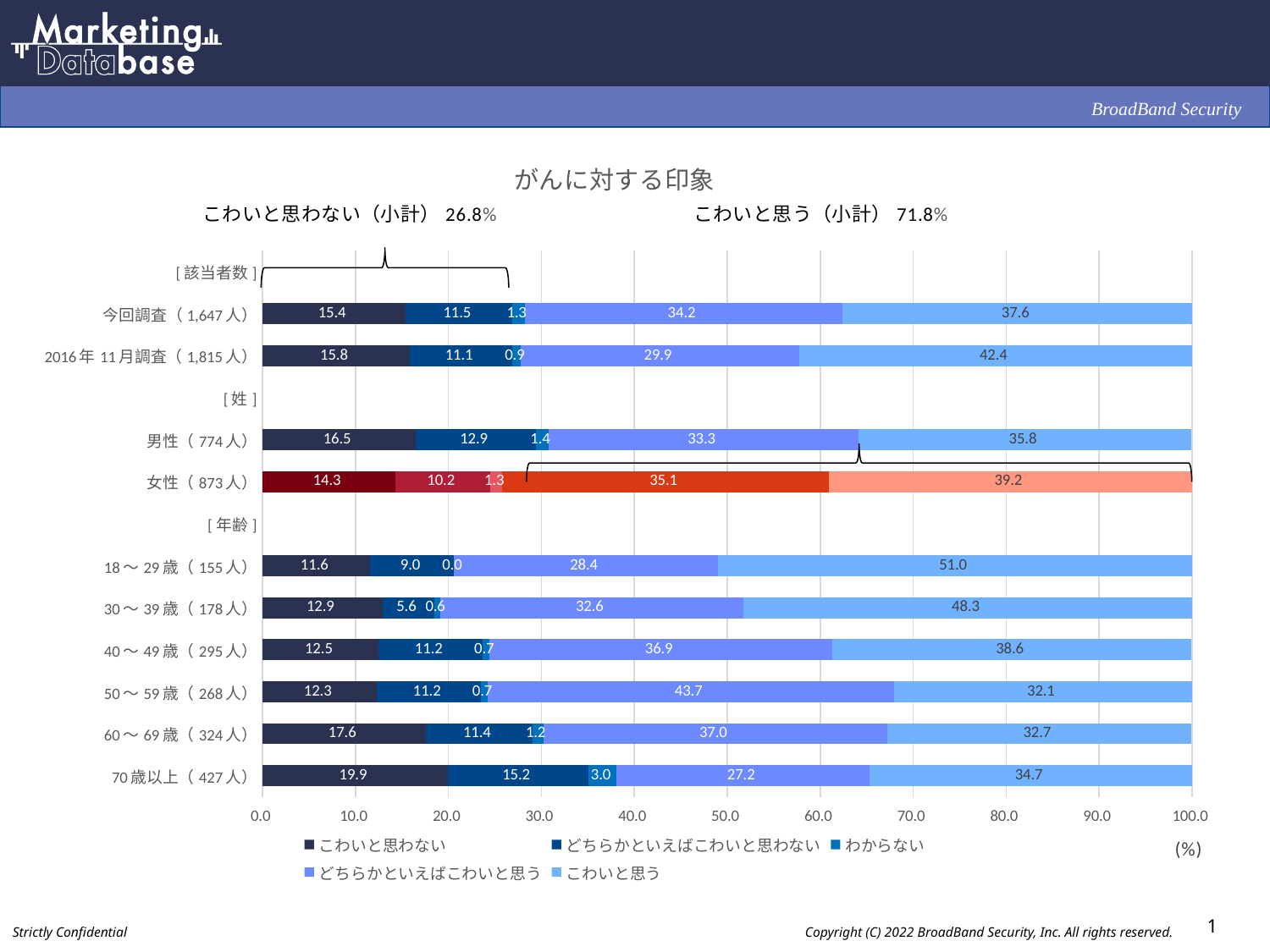
What is the value of こわいと思う for 18～29歳 (155人)? 51.0 What is the difference between the こわいと思う values for 男性 (774人) and 女性 (873人)? 3.4 What is the value of どちらかといえばこわいと思う for 50～59歳 (268人)? 43.7 Which category has the highest value for こわいと思う? 18～29歳 (155人) How many series does the legend list? 5 Which is larger, the どちらかといえばこわいと思う value for 今回調査 (1,647人) or for 2016年11月調査 (1,815人)? 今回調査 (1,647人) What is the value of こわいと思わない for 70歳以上 (427人)? 19.9 What is the こわいと思う (小計) percentage shown above the chart? 71.8% Which category has the lowest value for どちらかといえばこわいと思わない? 30～39歳 (178人) What is the title of the chart? がんに対する印象 What is the value of わからない for 2016年11月調査 (1,815人)? 0.9 What type of chart is shown on the slide? Stacked bar chart